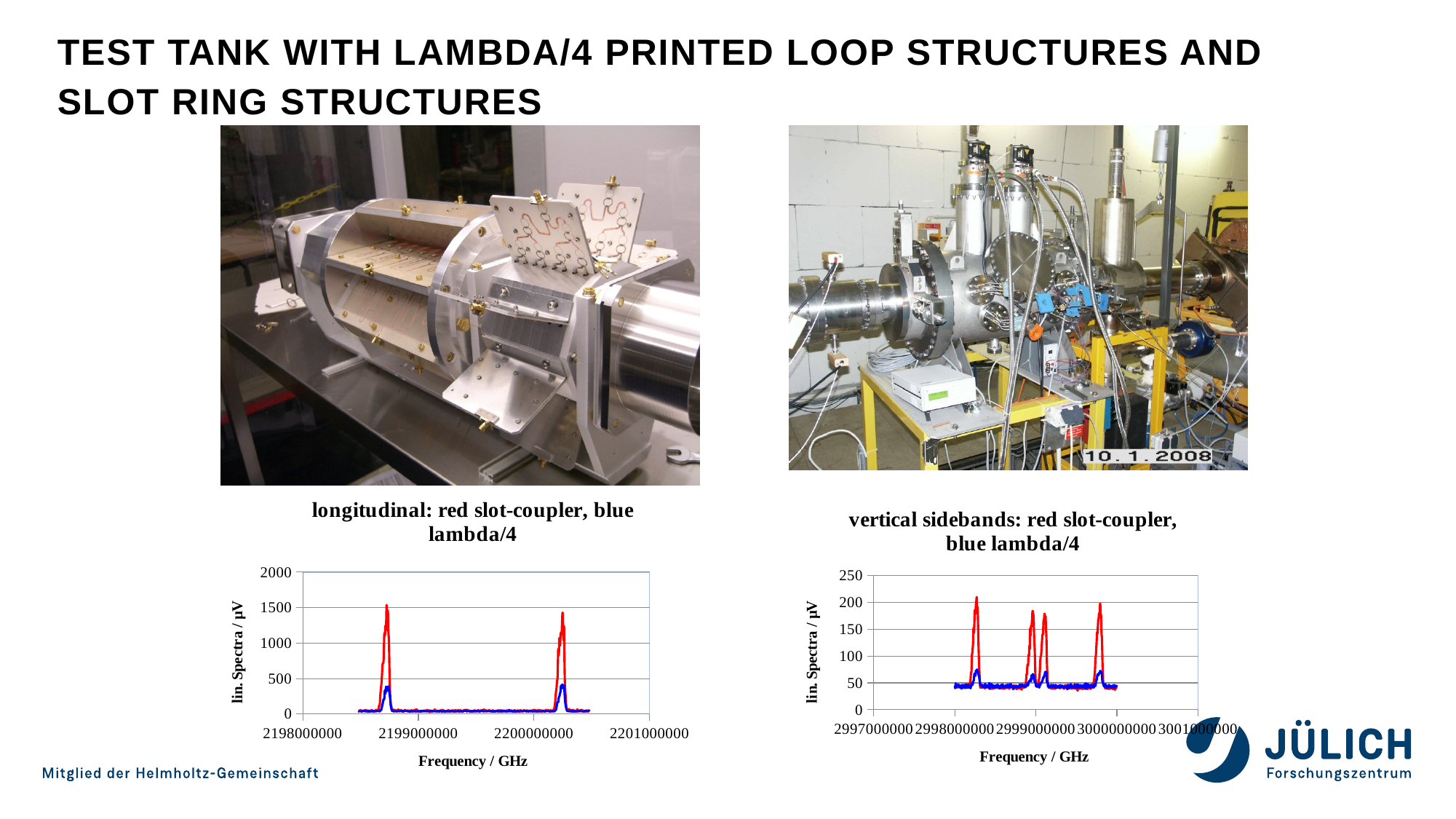
In the right chart (vertical sidebands), is the highest blue peak greater or less than 100? less How many distinct red peaks are visible in the right chart (vertical sidebands)? 4 What is the label of the y-axis on the left chart (longitudinal)? lin. Spectra / µV What kind of chart is the right chart titled "vertical sidebands: red slot-coupler, blue lambda/4"? line chart In the left chart (longitudinal), is the highest blue peak greater or less than 500? less In the right chart (vertical sidebands), is the highest red peak greater or less than 200? greater In the left chart (longitudinal), which trace reaches higher peaks, the red slot-coupler or the blue lambda/4? red slot-coupler In the right chart (vertical sidebands), which trace reaches higher peaks, the red slot-coupler or the blue lambda/4? red slot-coupler How many distinct red peaks are visible in the left chart (longitudinal)? 2 What is the label of the x-axis on the right chart (vertical sidebands)? Frequency / GHz What kind of chart is the left chart titled "longitudinal: red slot-coupler, blue lambda/4"? line chart